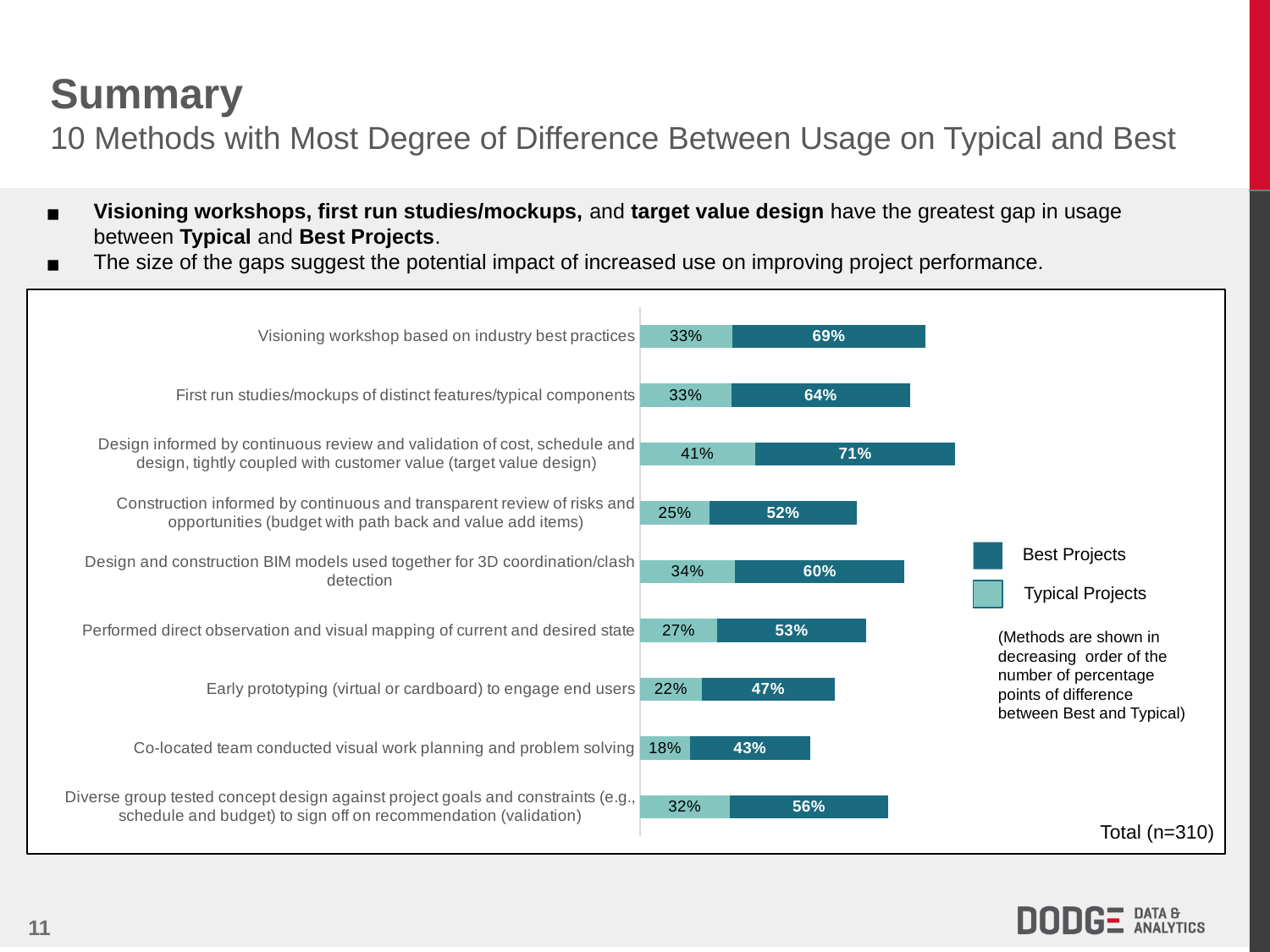
What is the difference between the Best Projects and Typical Projects values for 'First run studies/mockups of distinct features/typical components'? 31 percentage points What is the Best Projects value for 'Co-located team conducted visual work planning and problem solving'? 43% Which method has the highest Best Projects value? Design informed by continuous review and validation of cost, schedule and design, tightly coupled with customer value (target value design) Which method has the lowest Typical Projects value? Co-located team conducted visual work planning and problem solving Which is larger: the Best Projects value for 'Performed direct observation and visual mapping of current and desired state' or the Best Projects value for 'Diverse group tested concept design against project goals and constraints'? Diverse group tested concept design against project goals and constraints What is the Typical Projects value for 'Early prototyping (virtual or cardboard) to engage end users'? 22% Which series is shown in the darker teal colour in the legend? Best Projects What is the Best Projects value for 'Visioning workshop based on industry best practices'? 69% What is the total of the stacked bar for 'Construction informed by continuous and transparent review of risks and opportunities'? 77% What kind of chart is shown on the slide? Bar chart How many methods (categories) are plotted in the chart? 9 How many series does the legend list? 2